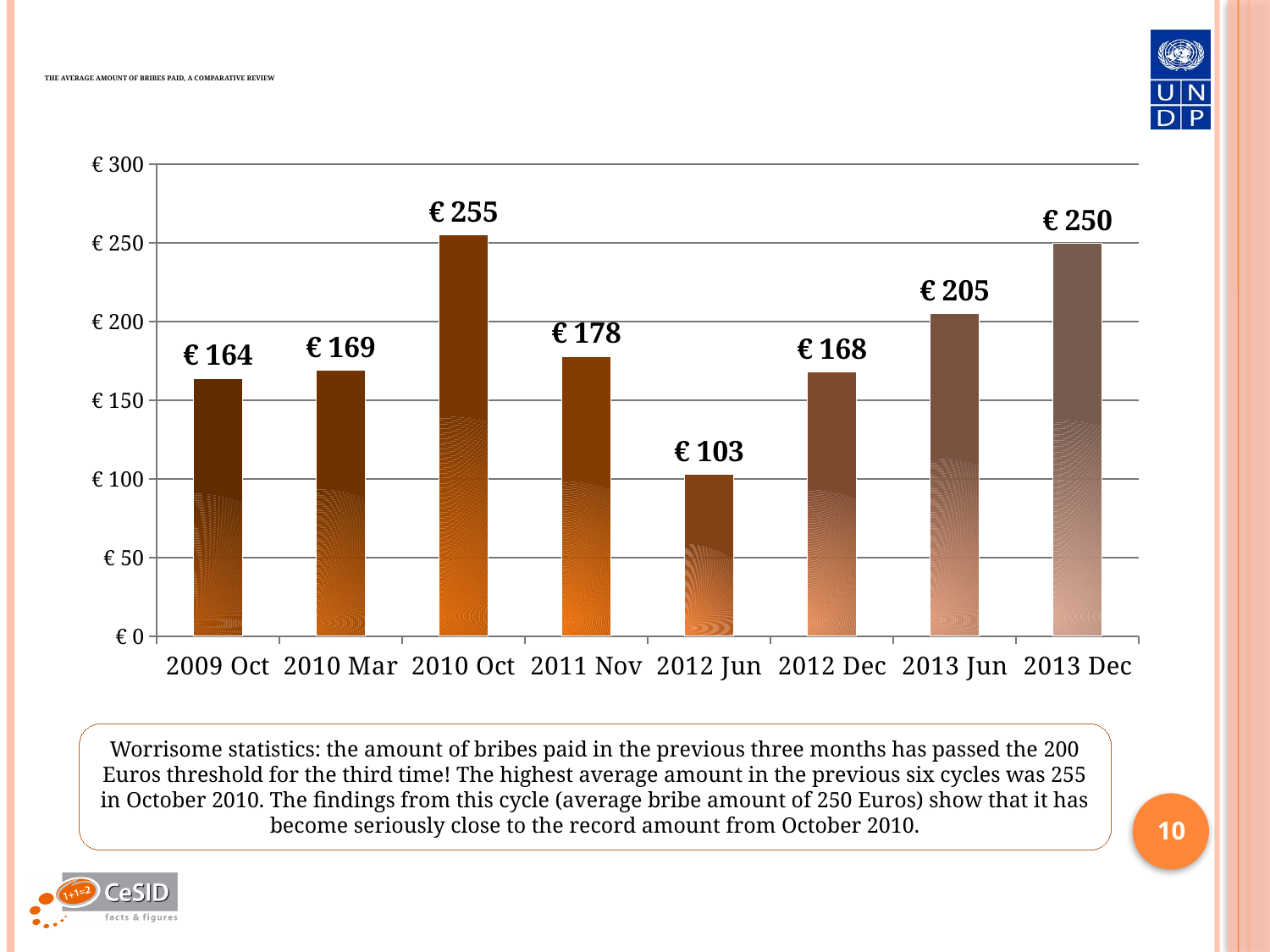
How many periods are shown on the x axis? 8 What is the average bribe amount shown for 2012 Jun? € 103 What is the difference between the values for 2013 Jun and 2012 Dec? € 37 Which period has the lowest average bribe amount? 2012 Jun What is the average bribe amount shown for 2013 Dec? € 250 Which period has the highest average bribe amount? 2010 Oct What is the average bribe amount shown for 2010 Oct? € 255 Is the value for 2013 Jun greater or less than € 200? greater What is the difference between the values for 2010 Oct and 2013 Dec? € 5 What kind of chart is shown on the slide? bar chart Which is larger, the value for 2011 Nov or the value for 2012 Dec? 2011 Nov Do the values rise or fall from 2012 Jun to 2013 Dec? rise